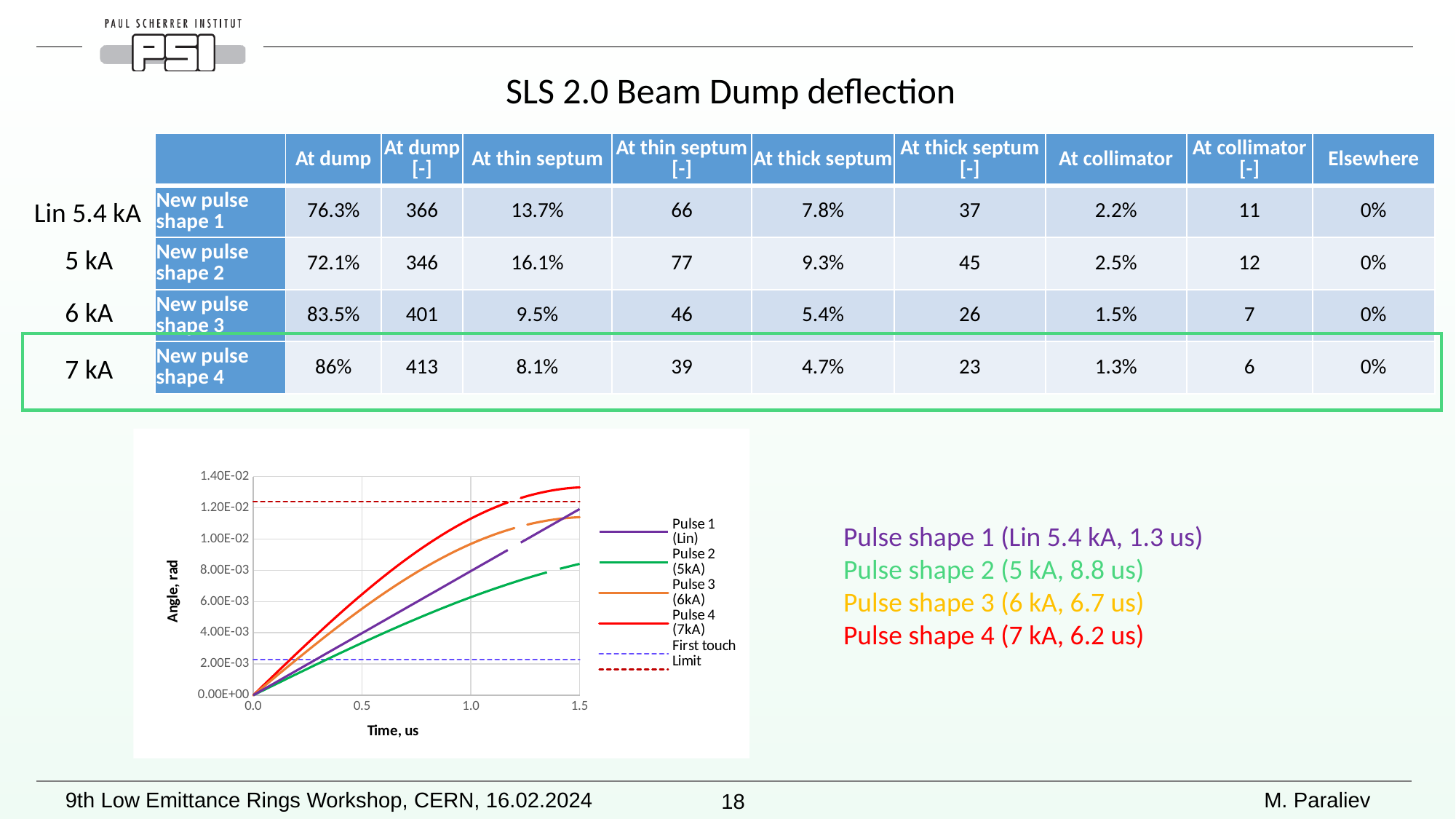
Does the angle for Pulse 4 (7kA) rise or fall as time increases? rise How many entries does the chart legend list? 6 What kind of chart is shown on the slide? line chart Which pulse series has the lowest angle at 1.5 us? Pulse 2 (5kA) Is the angle for Pulse 1 (Lin) at 1.5 us greater or less than 1.00E-02? greater What is the title of the y axis of the chart? Angle, rad Is the angle for Pulse 2 (5kA) at 1.5 us greater or less than 1.00E-02? less Which pulse series crosses above the dashed Limit line? Pulse 4 (7kA) What is the title of the x axis of the chart? Time, us Which pulse series reaches the highest angle at 1.5 us? Pulse 4 (7kA) At 1.0 us, which has the larger angle: Pulse 4 (7kA) or Pulse 2 (5kA)? Pulse 4 (7kA) Is the angle for Pulse 4 (7kA) at 1.5 us greater or less than 1.20E-02? greater